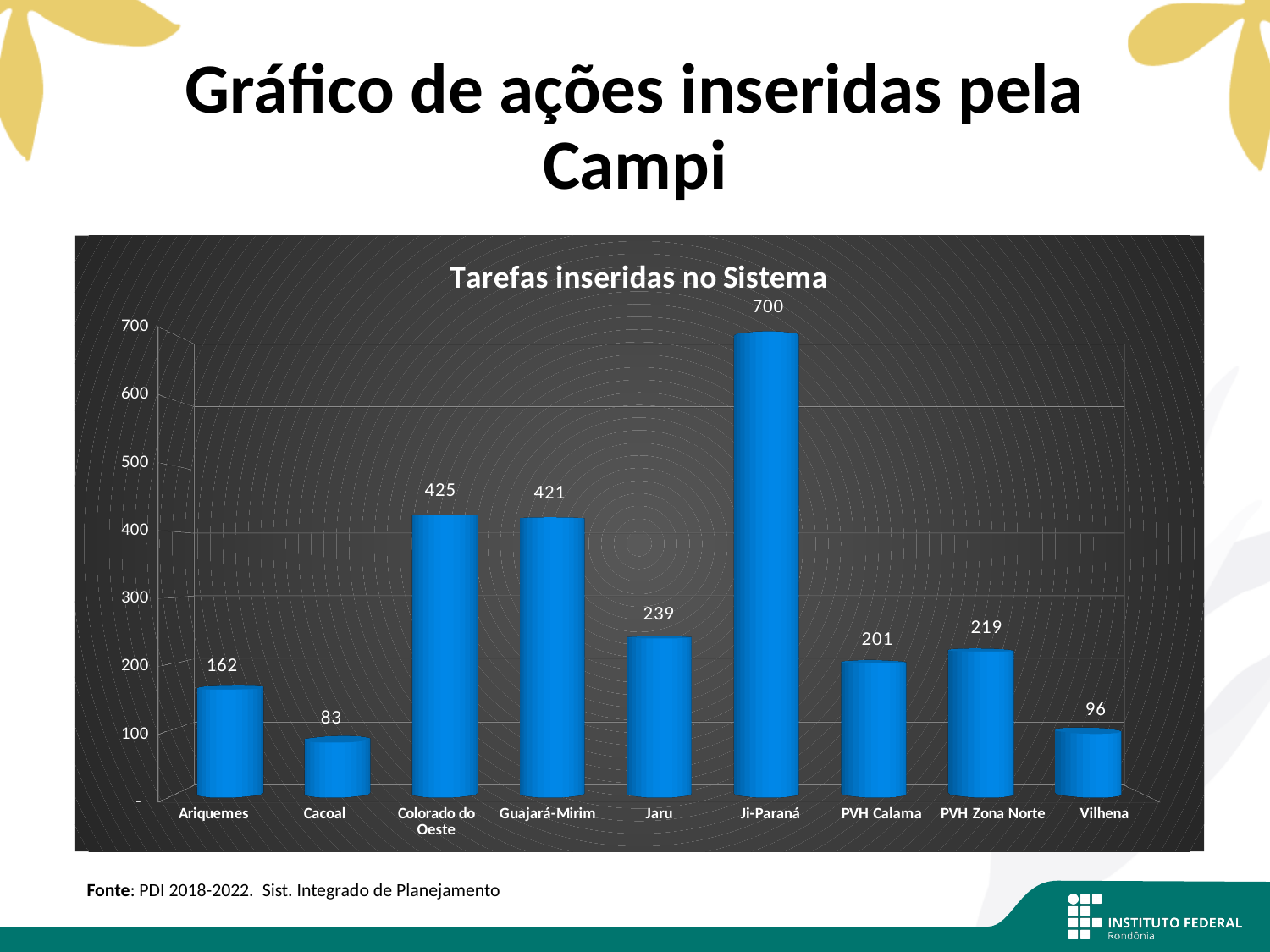
How many campuses are shown on the x axis? 9 Which campus has the highest number of tasks inserted? Ji-Paraná Is the value for PVH Calama greater or less than 300? less Which is larger, the value for Ariquemes or the value for Vilhena? Ariquemes What is the title of the chart? Tarefas inseridas no Sistema What is the difference between the values for Ji-Paraná and Jaru? 461 What is the value for Cacoal? 83 What is the value for Ji-Paraná? 700 Which campus has the lowest number of tasks inserted? Cacoal What is the value for PVH Zona Norte? 219 What kind of chart is shown on the slide? bar chart What is the difference between the values for Colorado do Oeste and Guajará-Mirim? 4